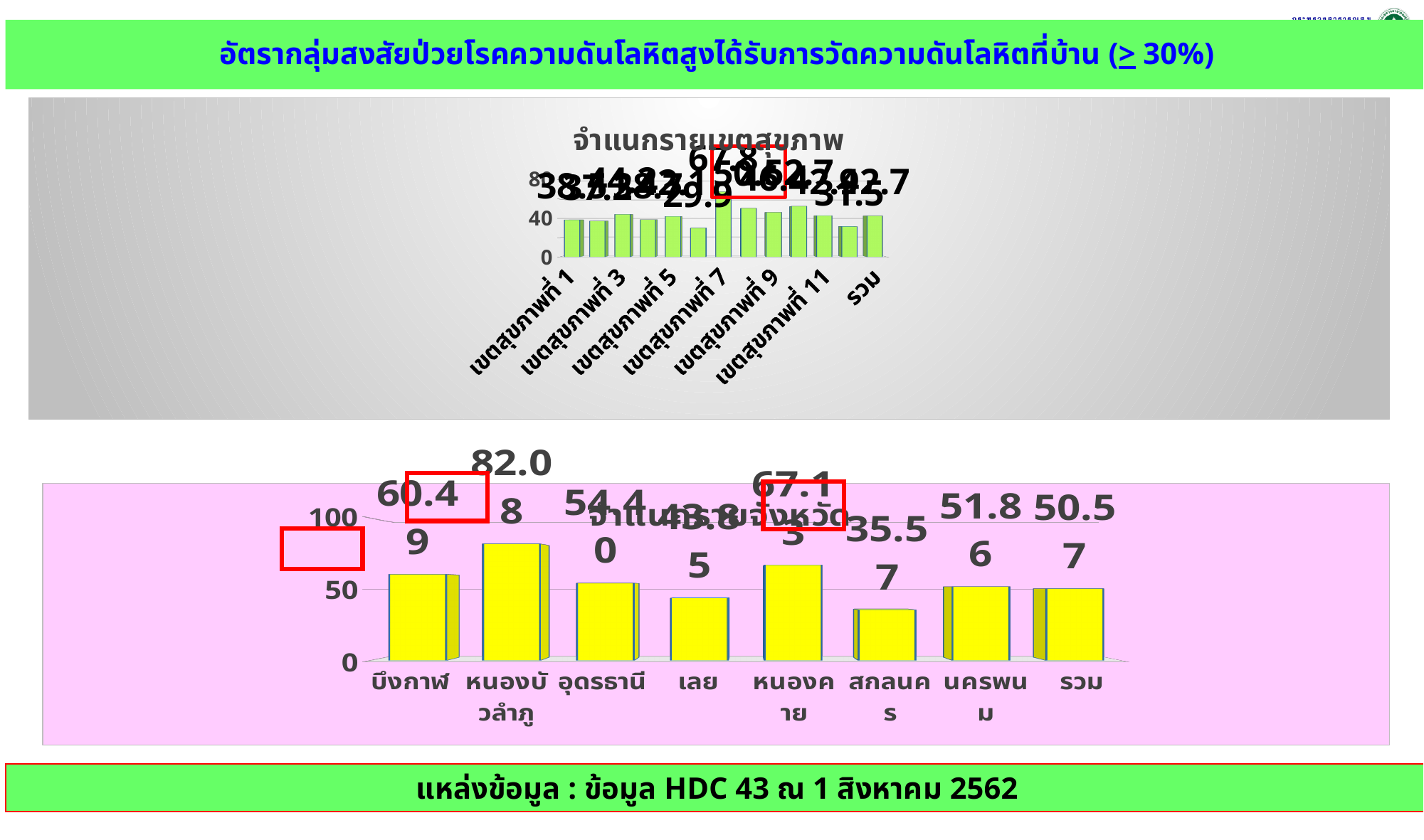
What kind of chart is the bottom chart (จำแนกรายจังหวัด)? bar chart On the bottom chart (จำแนกรายจังหวัด), what is the value for รวม? 50.57 On the bottom chart (จำแนกรายจังหวัด), which category has the lowest value? สกลนคร On the top chart (จำแนกรายเขตสุขภาพ), is the value for เขตสุขภาพที่ 7 greater or less than 40? greater On the bottom chart (จำแนกรายจังหวัด), which province has the highest value? หนองบัวลำภู On the bottom chart (จำแนกรายจังหวัด), what is the value for สกลนคร? 35.57 On the bottom chart (จำแนกรายจังหวัด), is the value for เลย greater or less than 50? less On the bottom chart (จำแนกรายจังหวัด), which is larger, the value for บึงกาฬ or the value for อุดรธานี? บึงกาฬ On the bottom chart (จำแนกรายจังหวัด), what is the difference between the values for หนองบัวลำภู and สกลนคร? 46.51 How many categories are shown on the bottom chart (จำแนกรายจังหวัด)? 8 On the bottom chart (จำแนกรายจังหวัด), what is the value for หนองบัวลำภู? 82.08 How many bars are shown on the top chart (จำแนกรายเขตสุขภาพ)? 13